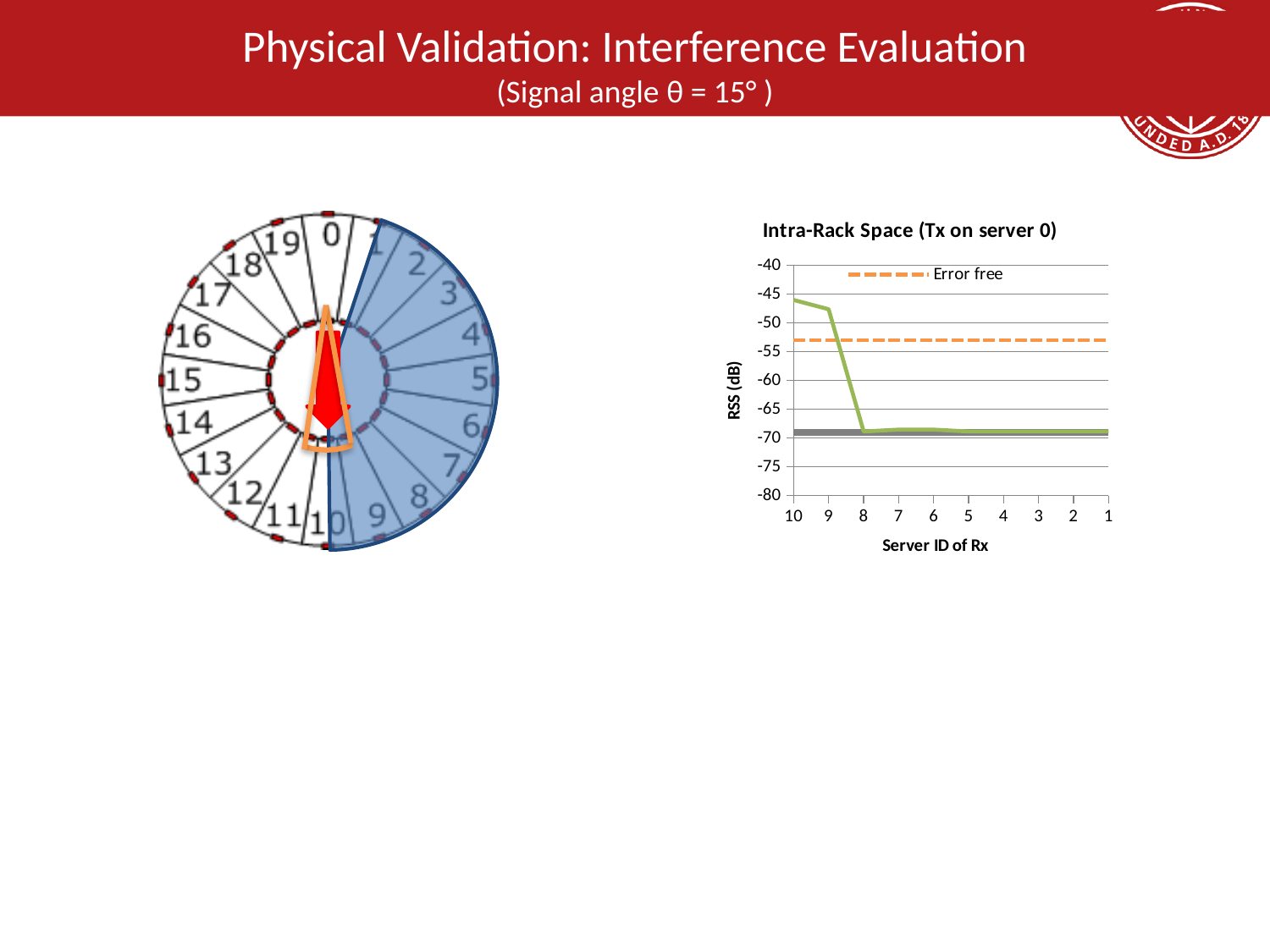
What is the title of the chart? Intra-Rack Space (Tx on server 0) What is the label of the y axis of the chart? RSS (dB) Which server ID of Rx has the highest RSS on the green line? 10 Is the RSS for server ID 8 greater or less than -65? less Moving from server ID 10 to server ID 1 along the x axis, does the green RSS line rise or fall overall? fall What kind of chart is shown on the slide? line chart Is the RSS for server ID 1 greater or less than -60? less How many server IDs are shown along the x axis of the chart? 10 Is the Error free dashed line greater or less than -50? less Which has the larger RSS on the green line, server ID 9 or server ID 7? 9 How many series does the chart's legend list? 1